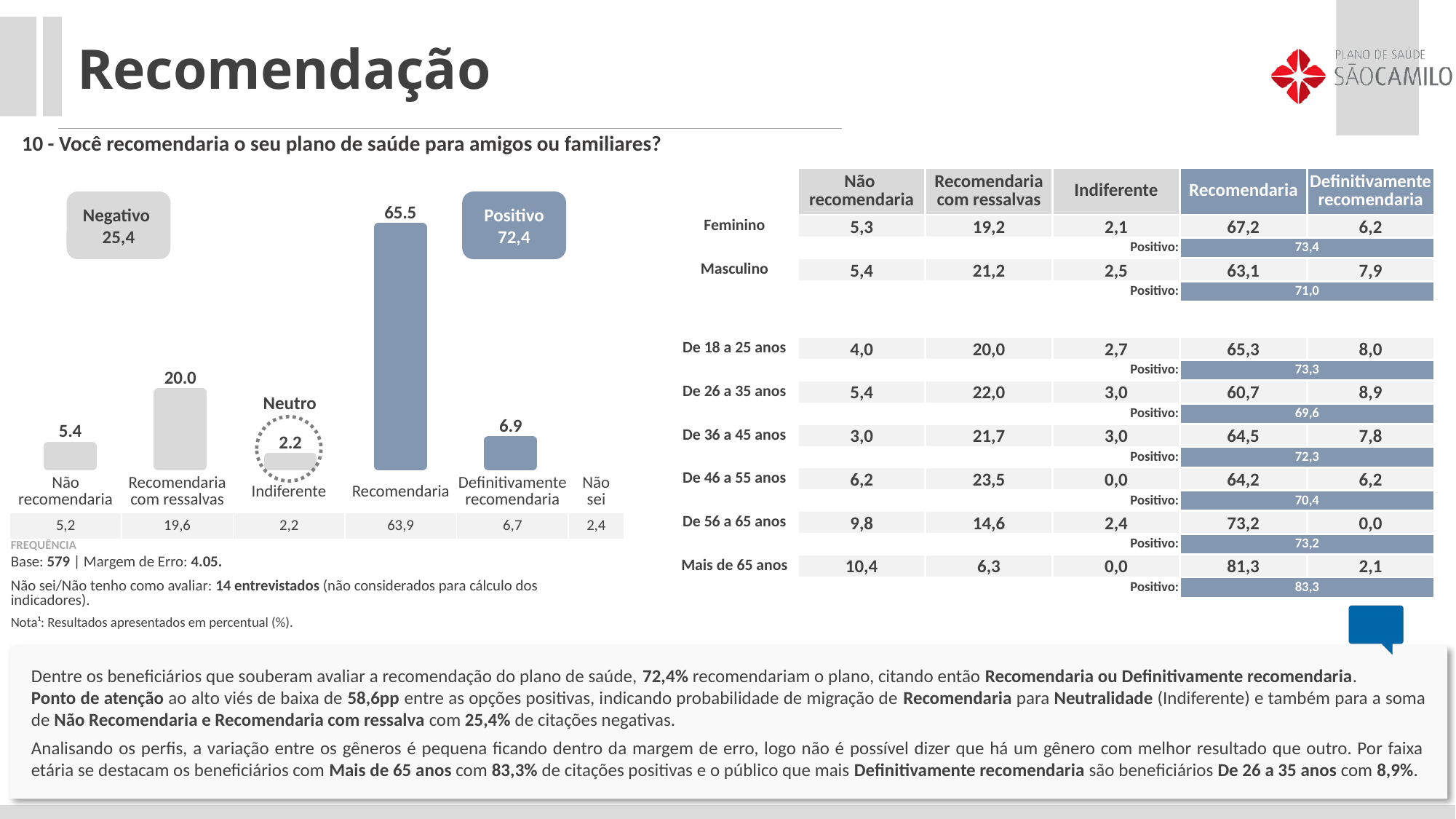
What is the value shown for the Recomendaria bar in the chart? 65.5 What kind of chart is shown on the left of the slide? Bar chart Which category has the highest bar in the chart? Recomendaria What is the value shown for the Definitivamente recomendaria bar in the chart? 6.9 What value is shown in the Positivo box above the chart? 72,4 What is the value shown for the Recomendaria com ressalvas bar in the chart? 20.0 Which category has the lowest bar in the chart? Indiferente Which is larger in the chart: Não recomendaria or Definitivamente recomendaria? Definitivamente recomendaria What is the value shown for the Indiferente bar in the chart? 2.2 What is the value shown for the Não recomendaria bar in the chart? 5.4 What is the difference between the Recomendaria bar and the Definitivamente recomendaria bar? 58.6 What is the difference between the Recomendaria com ressalvas bar and the Não recomendaria bar? 14.6